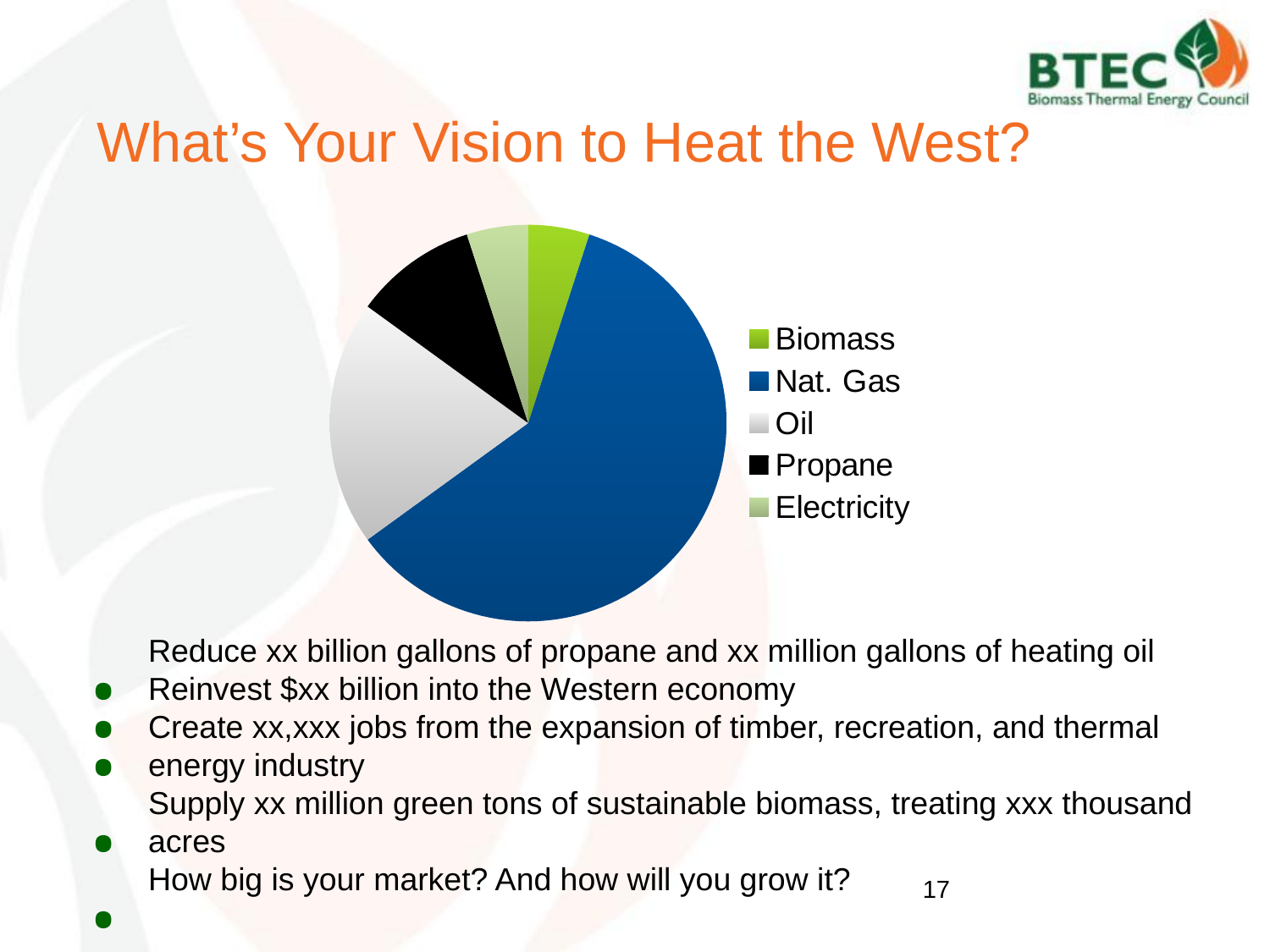
What colour is the Nat. Gas slice in the pie chart? blue Which slice is larger, Oil or Propane? Oil Which category is shown in black in the pie chart? Propane Which category has the largest slice of the pie chart? Nat. Gas How many entries does the legend of the pie chart list? 5 What kind of chart is shown on the slide? pie chart Which slice is larger, Oil or Electricity? Oil How many categories does the pie chart show? 5 Which slice is larger, Propane or Biomass? Propane